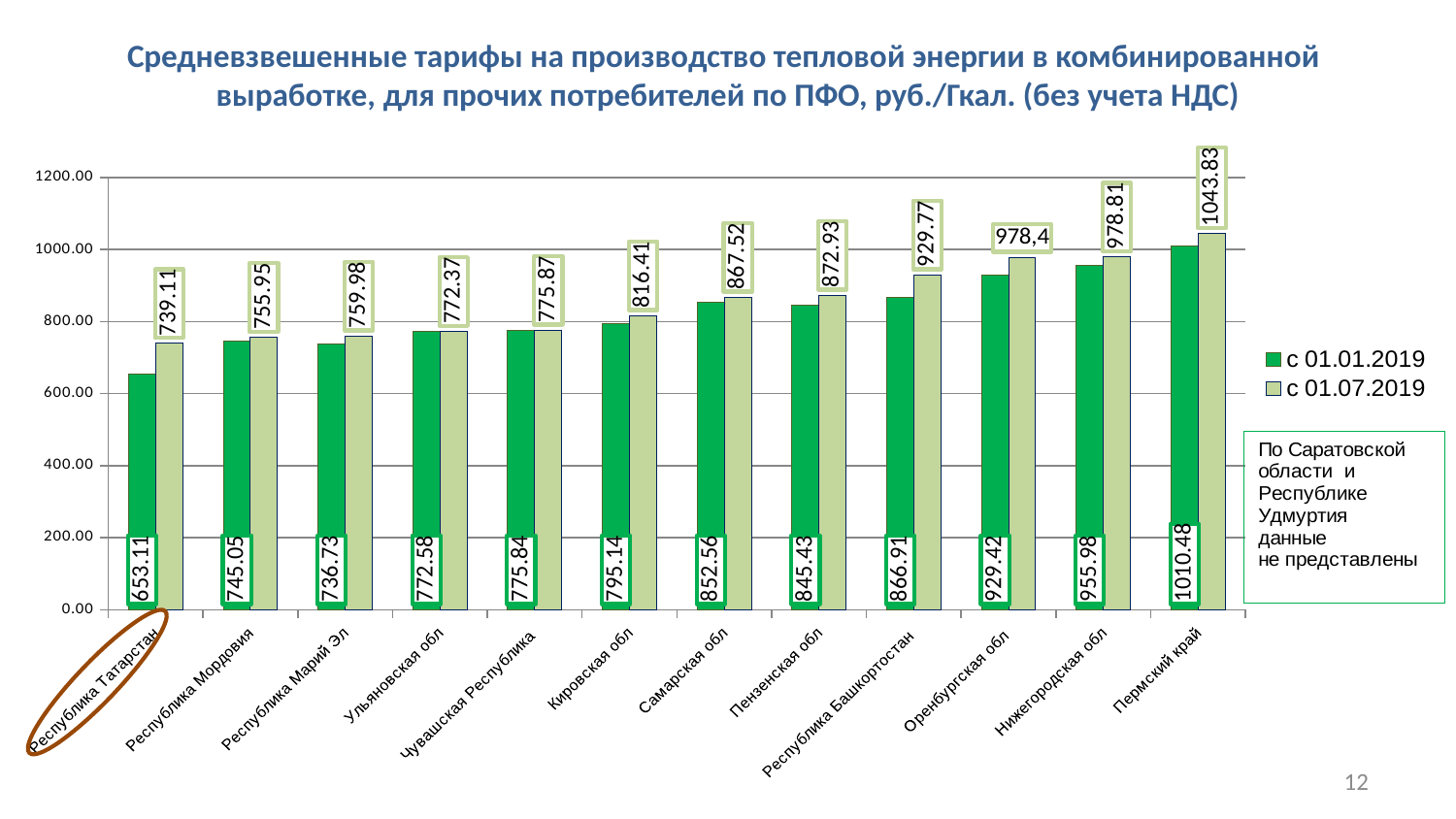
How many series does the legend list? 2 What is the value for Республика Татарстан in the series с 01.01.2019? 653.11 What is the value for Оренбургская обл in the series с 01.07.2019? 978,4 What is the value for Пермский край in the series с 01.07.2019? 1043.83 How many regions (categories) are shown on the x axis? 12 Which region has the highest value in the series с 01.01.2019? Пермский край Which is larger for Кировская обл: the value с 01.01.2019 or the value с 01.07.2019? с 01.07.2019 Which region has the lowest value in the series с 01.07.2019? Республика Татарстан What type of chart is shown on the slide? bar chart Do the values in the series с 01.01.2019 generally rise or fall from left to right along the x axis? rise Which two regions does the note on the slide say have no data presented? Саратовская область и Республика Удмуртия What is the difference between the с 01.07.2019 and с 01.01.2019 values for Республика Татарстан? 86.00